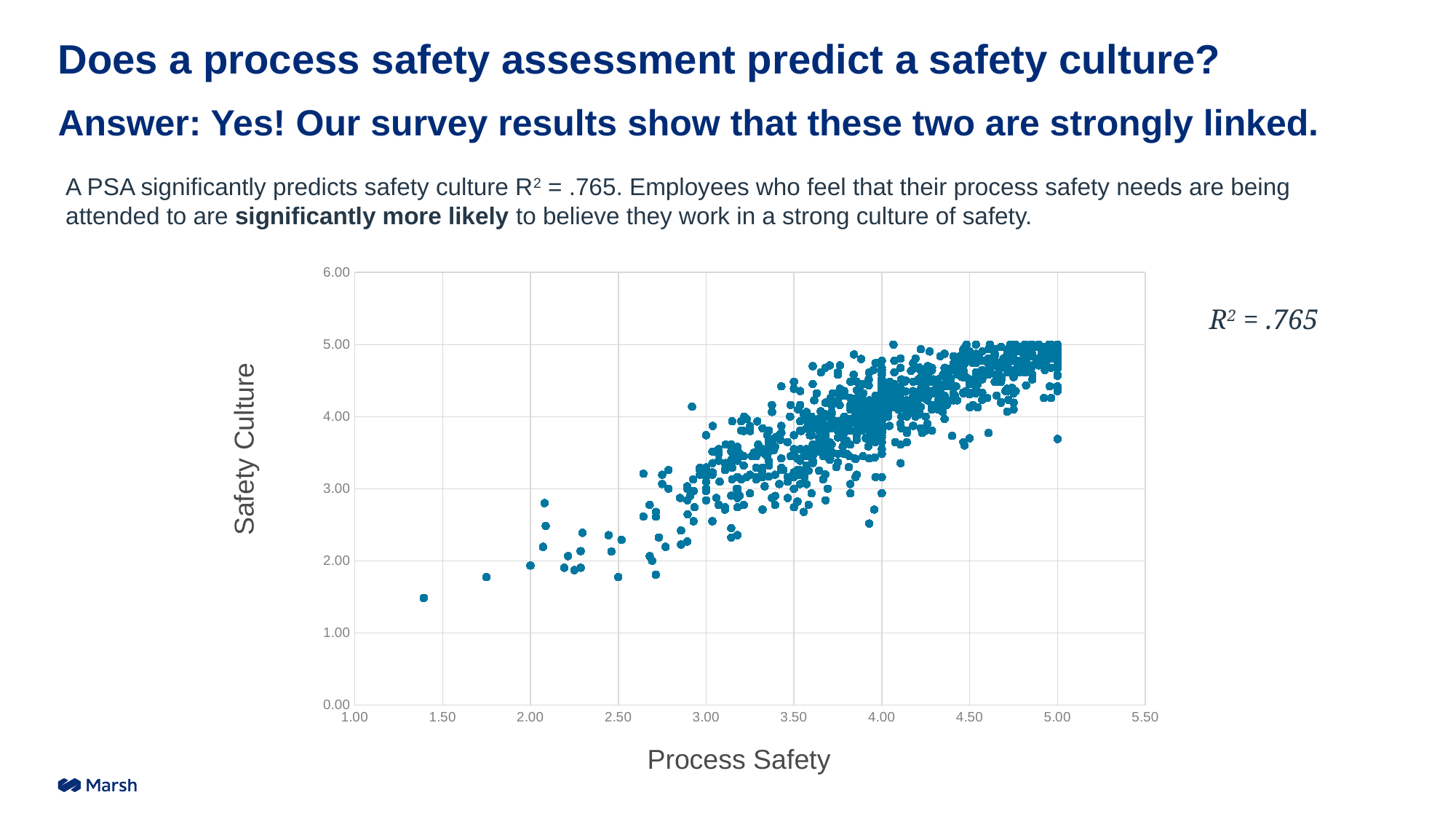
What is the label of the horizontal axis of the chart? Process Safety Is the lowest Safety Culture value plotted on the chart greater or less than 1.00? greater Is the highest Safety Culture value plotted on the chart greater or less than 5.50? less Is the Safety Culture value of the leftmost point on the chart greater or less than 2.00? less As Process Safety increases along the x axis, do the Safety Culture values generally rise or fall? Rise What is the label of the vertical axis of the chart? Safety Culture What R² value is printed next to the chart? R² = .765 What is the highest tick value shown on the horizontal axis? 5.50 What is the highest tick value shown on the vertical axis? 6.00 What kind of chart is shown on the slide? Scatter plot What is the lowest tick value shown on the horizontal axis? 1.00